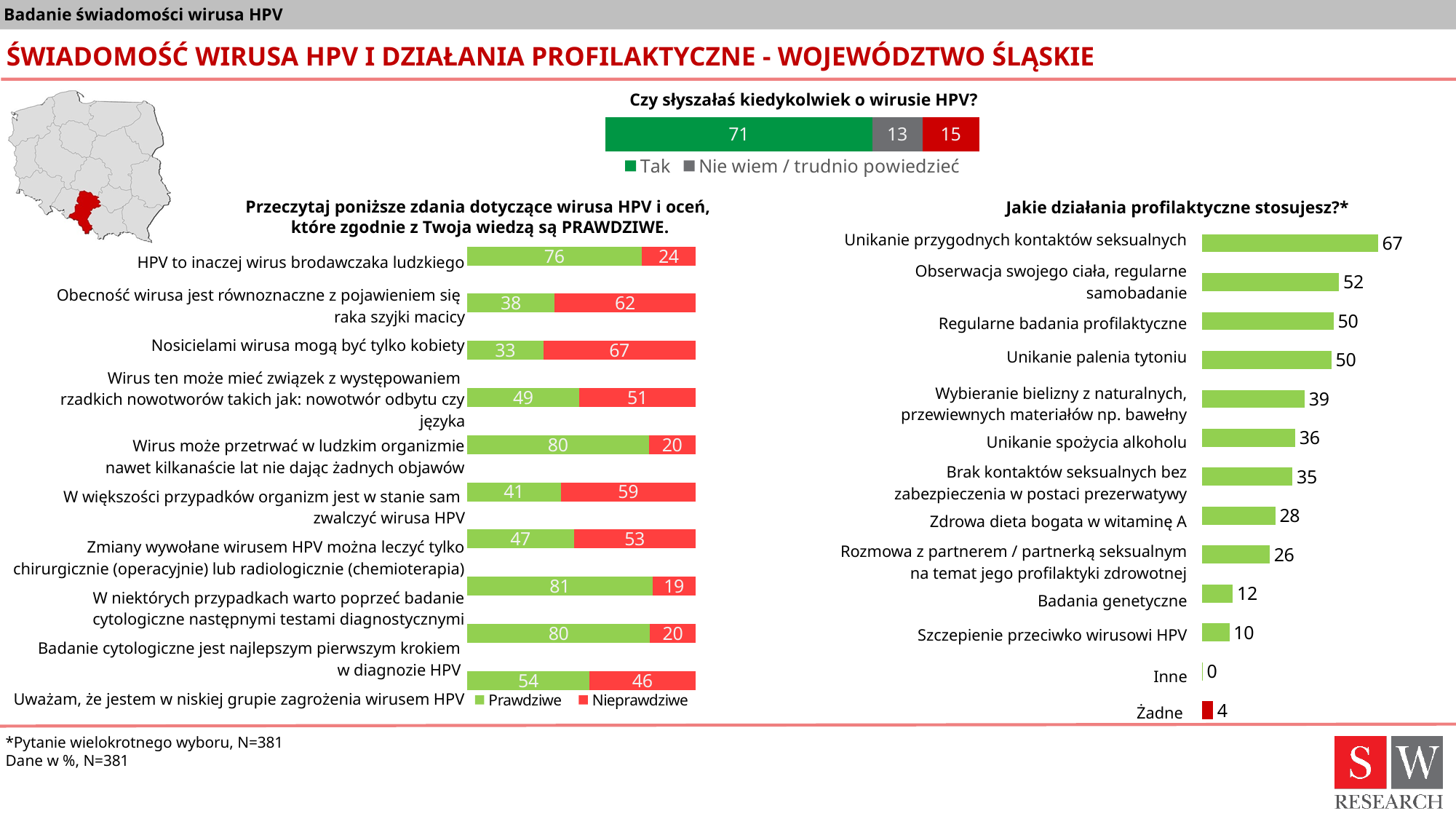
In the chart 'Czy słyszałaś kiedykolwiek o wirusie HPV?', what is the value for 'Nie wiem / trudnio powiedzieć'? 13 In the chart 'Jakie działania profilaktyczne stosujesz?', what is the difference between 'Unikanie przygodnych kontaktów seksualnych' and 'Obserwacja swojego ciała, regularne samobadanie'? 15 What type of chart is 'Jakie działania profilaktyczne stosujesz?'? Bar chart In the chart 'Jakie działania profilaktyczne stosujesz?', what is the value for 'Żadne'? 4 In the chart 'Jakie działania profilaktyczne stosujesz?', which is larger: 'Unikanie spożycia alkoholu' or 'Zdrowa dieta bogata w witaminę A'? Unikanie spożycia alkoholu In the chart 'Przeczytaj poniższe zdania dotyczące wirusa HPV...', what is the 'Nieprawdziwe' value for 'Nosicielami wirusa mogą być tylko kobiety'? 67 In the chart 'Jakie działania profilaktyczne stosujesz?', which category has the highest value? Unikanie przygodnych kontaktów seksualnych In the chart 'Jakie działania profilaktyczne stosujesz?', what is the value for 'Szczepienie przeciwko wirusowi HPV'? 10 In the chart 'Jakie działania profilaktyczne stosujesz?', how many categories are shown? 13 In the chart 'Przeczytaj poniższe zdania dotyczące wirusa HPV...', how many series does the legend list? 2 In the chart 'Przeczytaj poniższe zdania dotyczące wirusa HPV...', what is the 'Prawdziwe' value for 'HPV to inaczej wirus brodawczaka ludzkiego'? 76 In the chart 'Czy słyszałaś kiedykolwiek o wirusie HPV?', what is the value for 'Tak'? 71